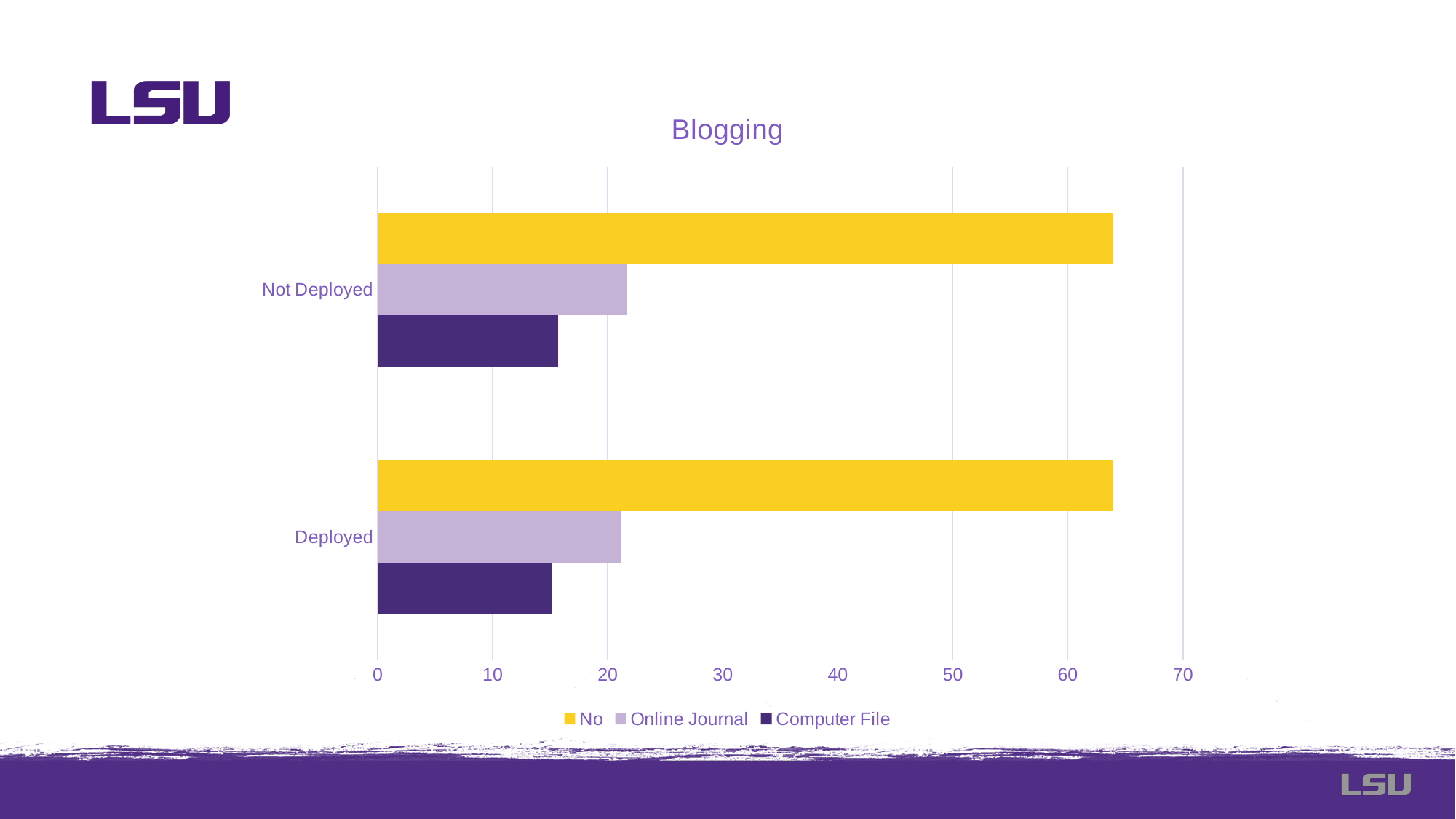
Is the value for Online Journal in the Deployed category greater or less than 30? less How many series does the legend list? 3 Is the value for Computer File in the Not Deployed category greater or less than 20? less What kind of chart is shown on the slide? bar chart Is the value for No in the Not Deployed category greater or less than 60? greater Which series has the highest value for Not Deployed? No What is the title of the chart? Blogging For Not Deployed, which is larger: Online Journal or Computer File? Online Journal Which legend entry is shown in yellow? No Which series has the lowest value for Deployed? Computer File How many categories are shown on the vertical axis? 2